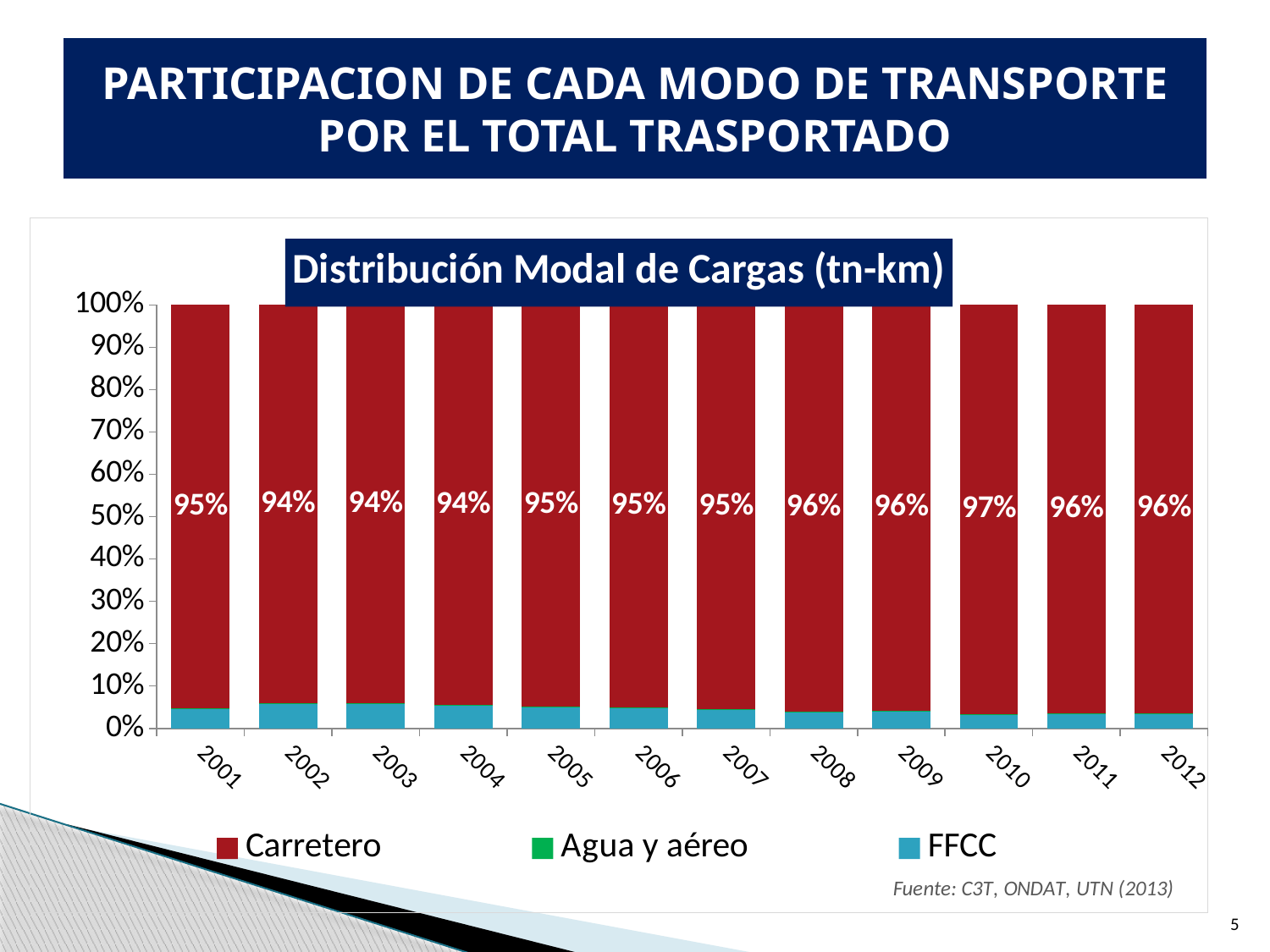
What is the Carretero share in 2010? 97% What is the title of the chart? Distribución Modal de Cargas (tn-km) What is the Carretero share in 2001? 95% What is the lowest Carretero share shown on the chart? 94% Is the FFCC share in 2001 greater or less than 10%? less How many series does the legend list? 3 How many years are shown on the x axis? 12 In which year is the Carretero share highest? 2010 What is the Carretero share in 2012? 96% What kind of chart is shown? Stacked bar chart What is the difference between the Carretero share in 2010 and in 2001? 2% Which year has a larger Carretero share, 2002 or 2010? 2010